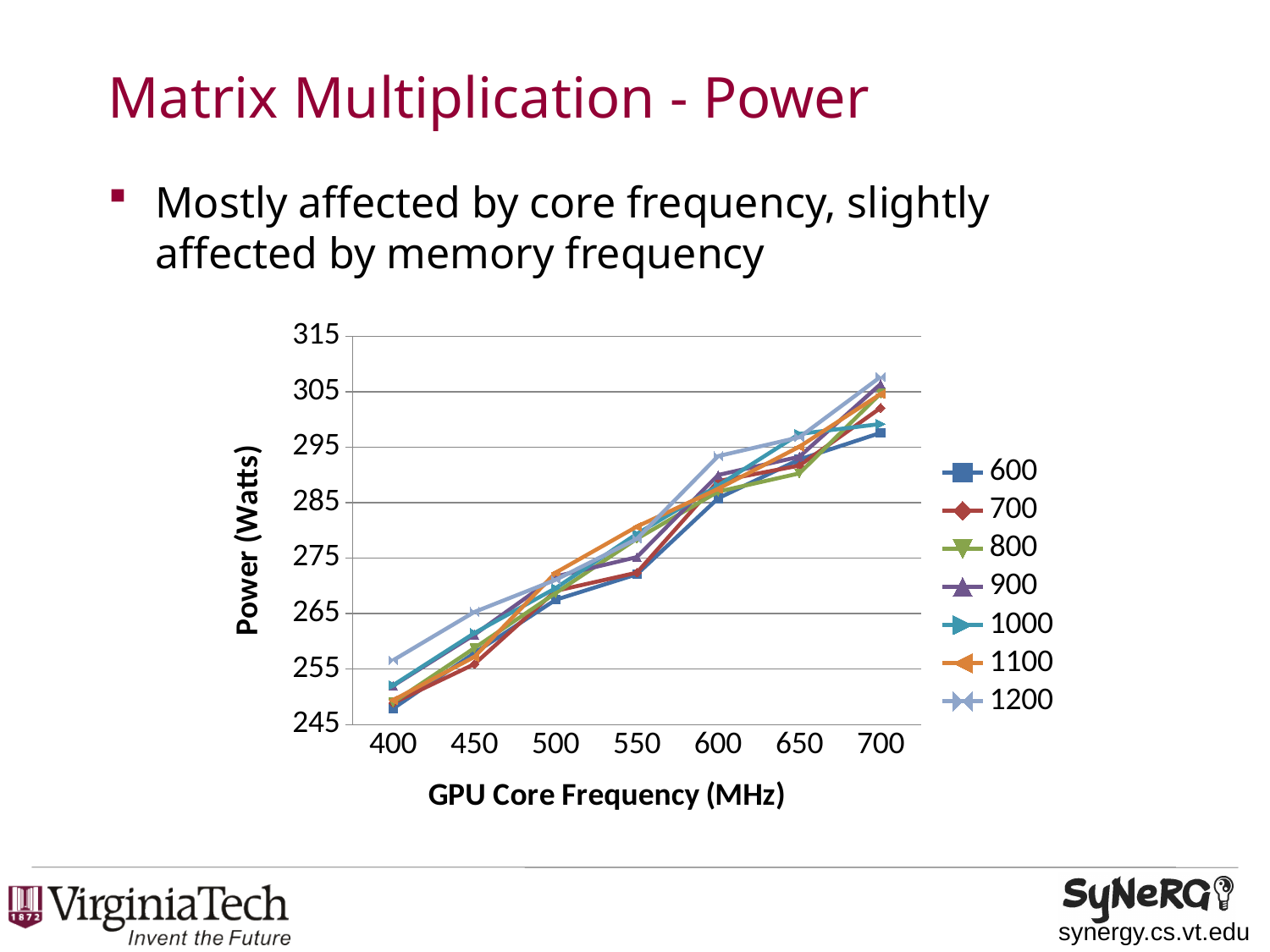
Is the value for the 600 series at 400 MHz greater or less than 255? less At 400 MHz, which series has the highest power? 1200 What kind of chart is shown on the slide? line chart What is the title of the y axis? Power (Watts) How many GPU core frequency values are plotted along the x axis? 7 Do the power values rise or fall as GPU core frequency increases from 400 to 700 MHz? rise Is the value for the 1200 series at 400 MHz greater or less than 255? greater Is the value for the 1200 series at 600 MHz greater or less than 295? less At 400 MHz, which is larger: the value for the 1200 series or the 600 series? 1200 How many series does the legend list? 7